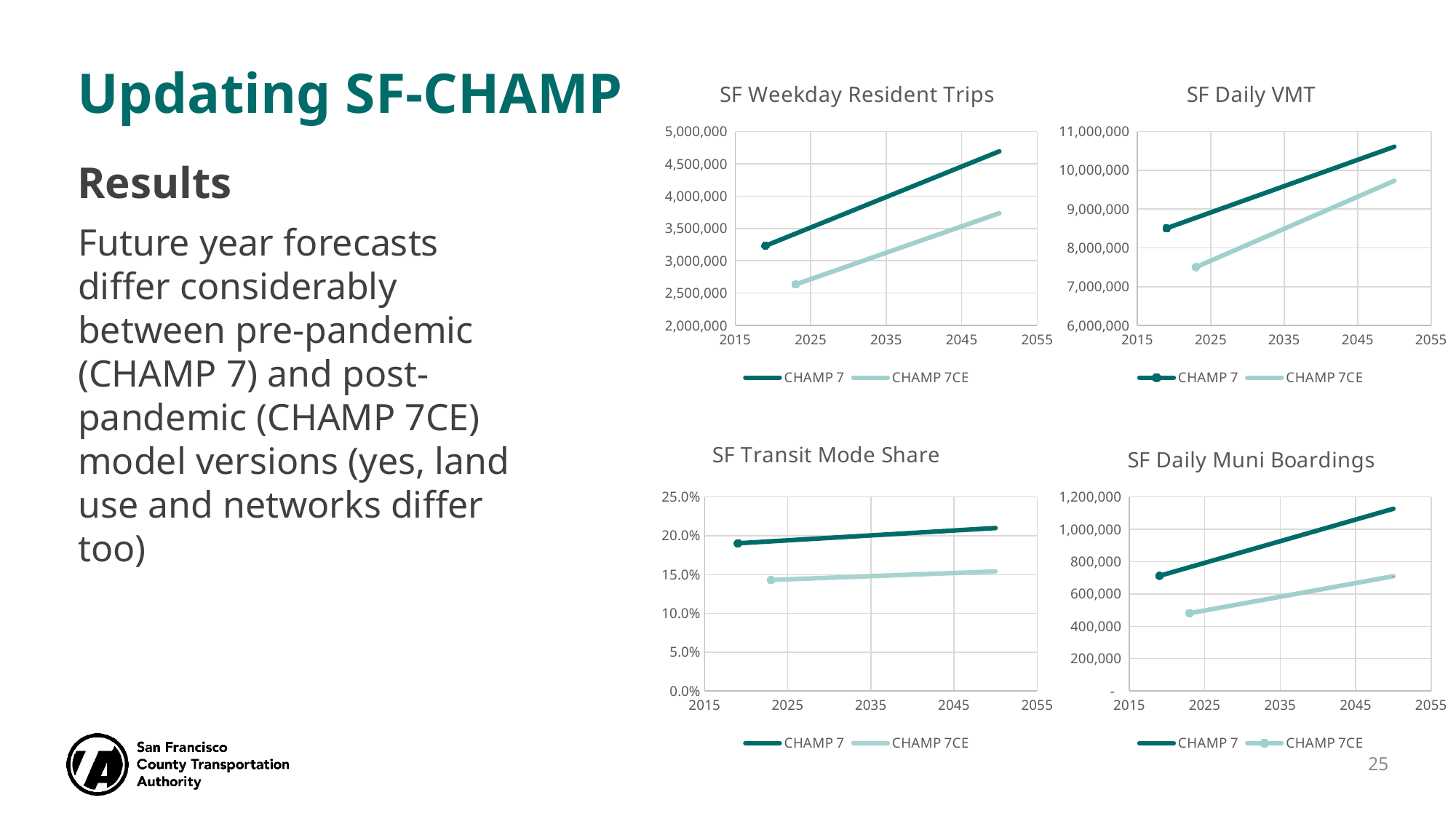
In the SF Daily Muni Boardings chart, is the CHAMP 7 value in 2050 greater or less than 1,000,000? greater In the SF Weekday Resident Trips chart, is the CHAMP 7CE value in 2050 greater or less than 4,000,000? less In the SF Transit Mode Share chart, which series is higher at its starting point, CHAMP 7 or CHAMP 7CE? CHAMP 7 In the SF Daily Muni Boardings chart, do the CHAMP 7 values rise or fall over time? rise In the SF Weekday Resident Trips chart, is the CHAMP 7 value in 2050 greater or less than 4,500,000? greater What is the title of the chart in the bottom-left position on the slide? SF Transit Mode Share What kind of chart is the SF Daily VMT chart? line chart How many series does the legend of the SF Weekday Resident Trips chart list? 2 In the SF Daily VMT chart, which series is higher in 2050, CHAMP 7 or CHAMP 7CE? CHAMP 7